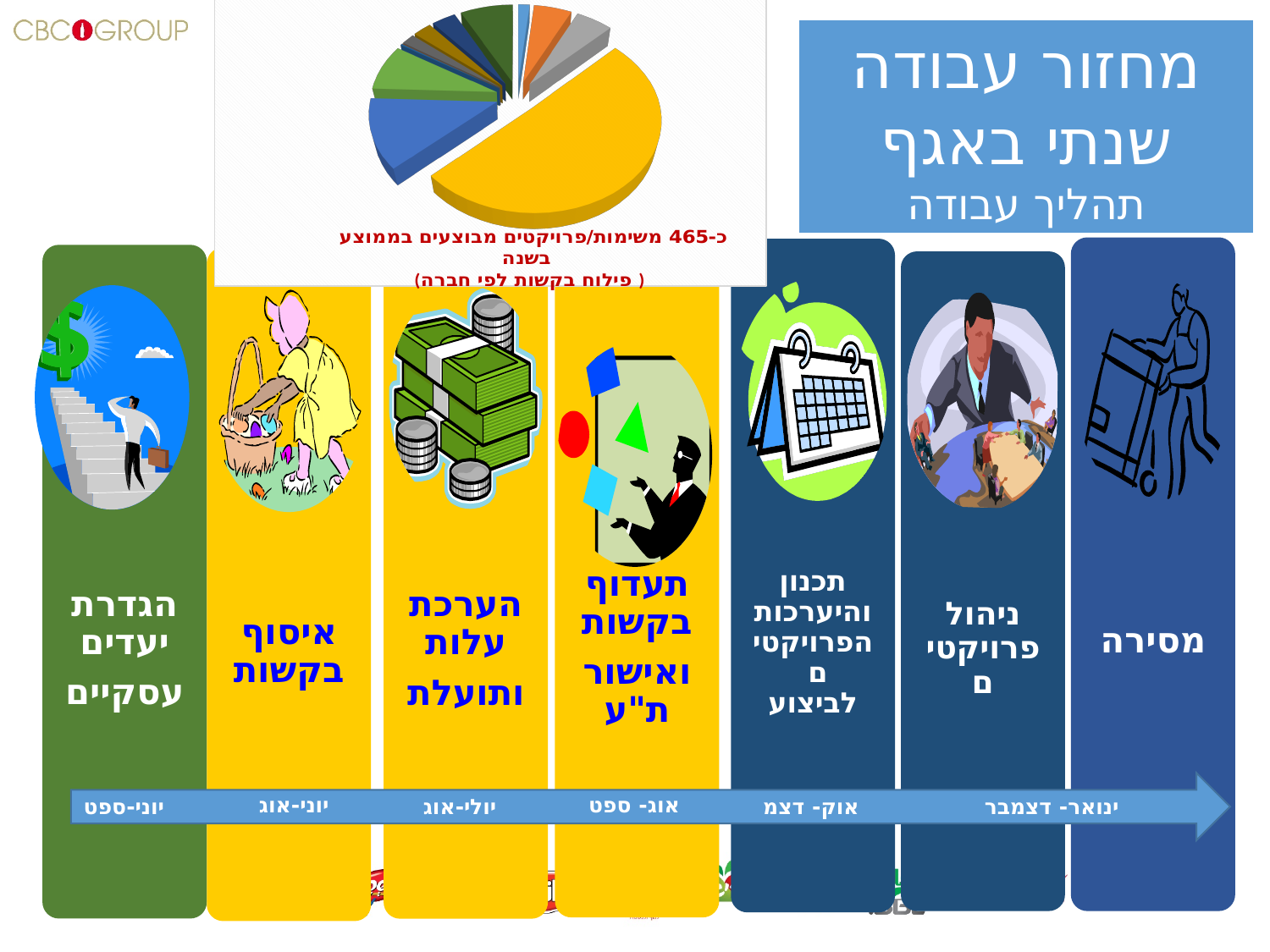
Does the pie chart display a legend identifying its slices? No According to the caption under the pie chart, about how many tasks/projects are carried out on average per year? כ-465 Which colour is the largest slice of the pie chart? yellow Which slice of the pie chart is larger, the yellow slice or the blue slice? the yellow slice What kind of chart is shown at the top of the slide? pie chart